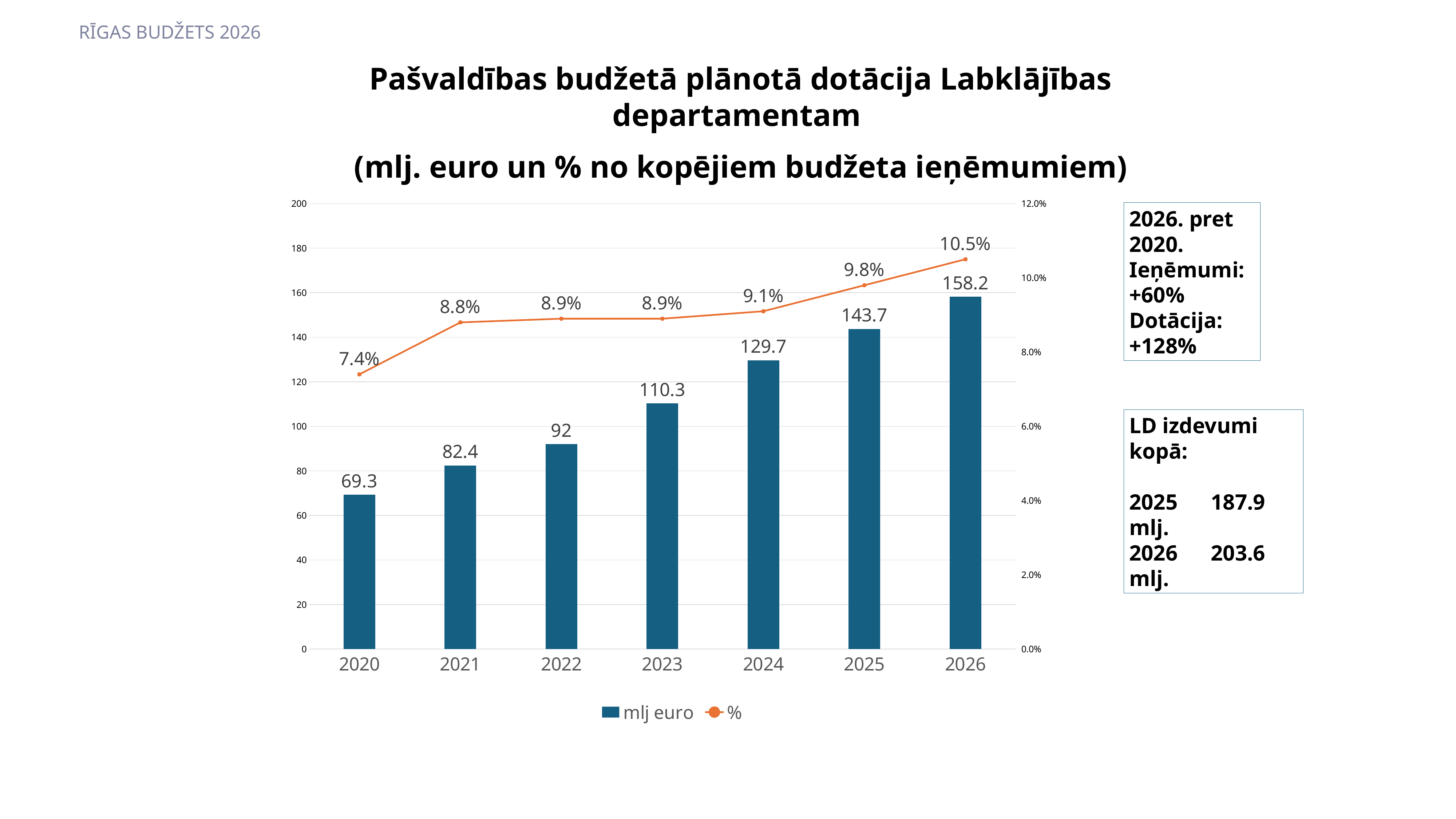
What kind of chart is this? Combined bar and line chart Is the mlj euro value for 2024 greater or less than 120? greater Which year has the lowest % value? 2020 What is the difference in mlj euro between 2026 and 2025? 14.5 What is the mlj euro value for 2023? 110.3 What is the mlj euro value for 2026? 158.2 How many series does the legend list? 2 How many years are shown on the x axis? 7 Which is larger, the mlj euro value for 2022 or for 2021? 2022 What is the % value for 2020? 7.4% Which year has the highest mlj euro value? 2026 Do the mlj euro values rise or fall from 2020 to 2026? rise